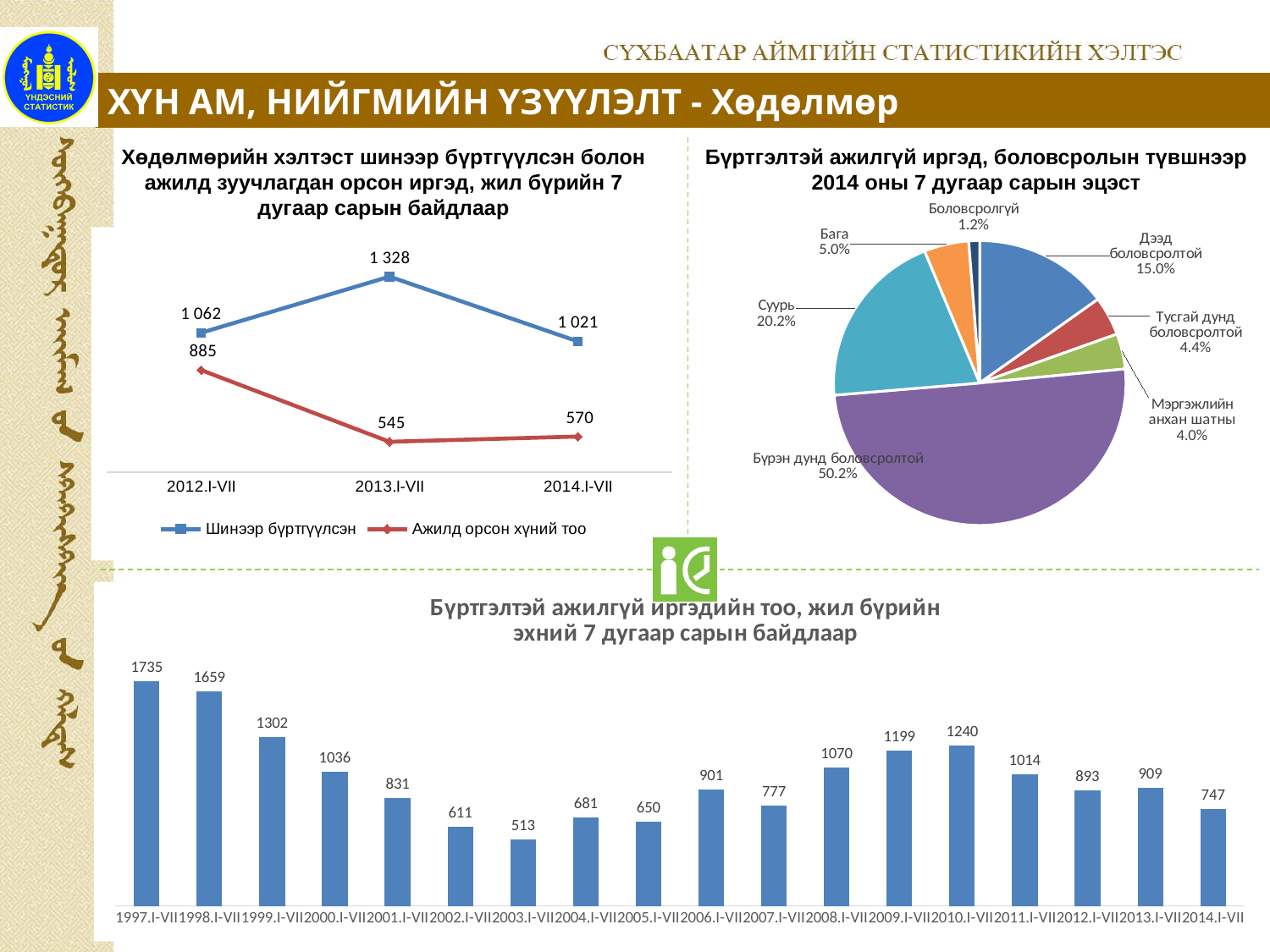
How many bars are in the bottom bar chart? 18 In the bottom bar chart, what is the value for 2010.I-VII? 1240 What kind of chart is the bottom chart titled 'Бүртгэлтэй ажилгүй иргэдийн тоо'? bar chart In the top-right pie chart, what share is Бүрэн дунд боловсролтой? 50.2% In the top-right pie chart, which category has the smallest slice? Боловсролгүй In the top-left line chart, what is the difference between Шинээр бүртгүүлсэн and Ажилд орсон хүний тоо for 2014.I-VII? 451 In the top-left line chart, what is the value of Шинээр бүртгүүлсэн for 2013.I-VII? 1 328 In the top-left line chart, what is the value of Ажилд орсон хүний тоо for 2012.I-VII? 885 In the bottom bar chart, which year has the lowest value? 2003.I-VII How many series does the legend of the top-left line chart list? 2 In the top-right pie chart, what is the value for Суурь? 20.2% In the bottom bar chart, which year has the highest value? 1997.I-VII